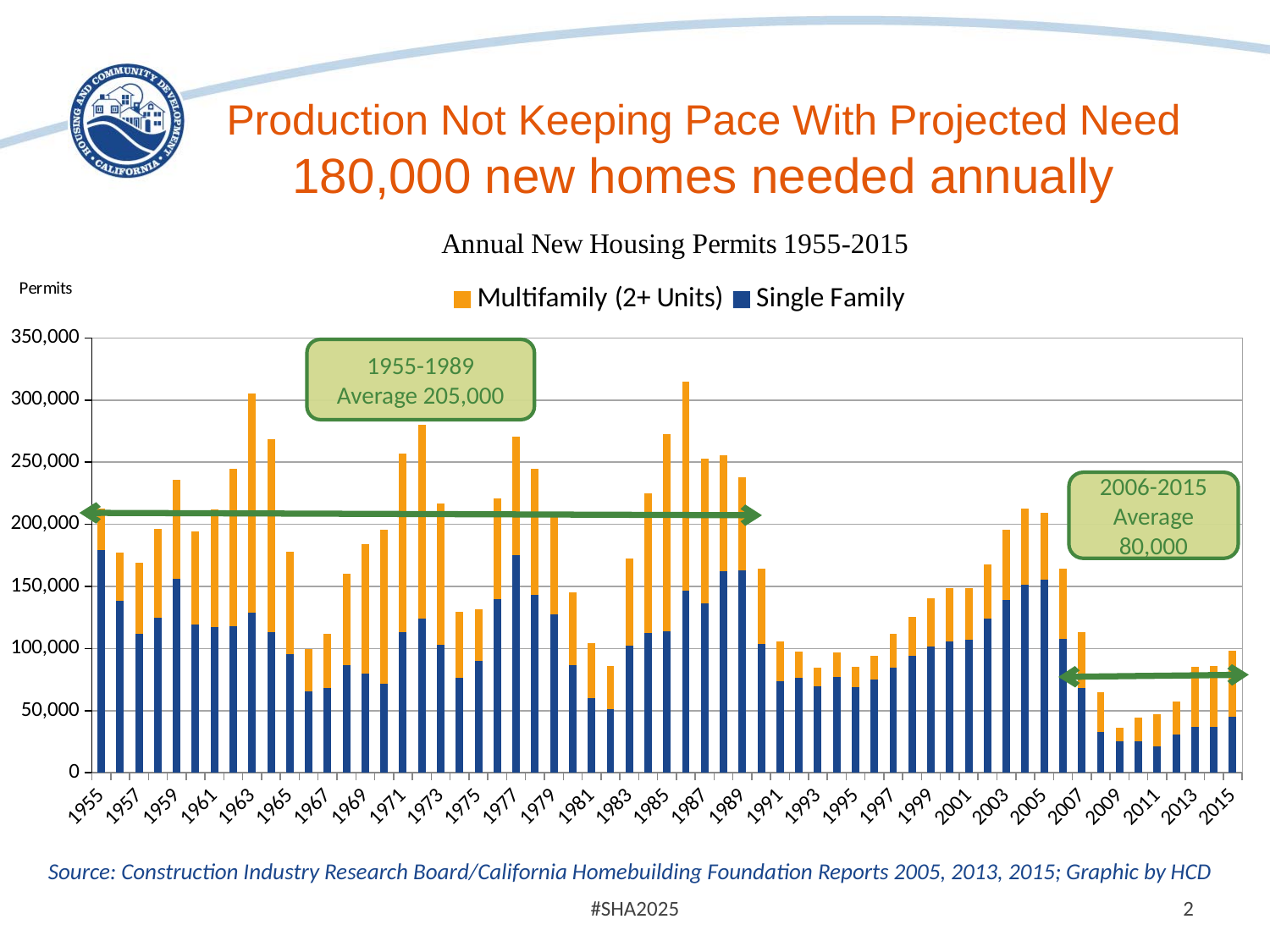
Is the total number of permits for 1986 greater or less than 300,000? greater Is the total number of permits for 1977 greater or less than 250,000? greater How many series does the chart legend list? 2 Which series is shown in orange in the chart? Multifamily (2+ Units) What type of chart is shown on the slide? Stacked bar chart Do total permits rise or fall from 2005 to 2009? fall According to the annotation on the chart, what was the average annual number of permits for 2006-2015? 80,000 According to the annotation on the chart, what was the average annual number of permits for 1955-1989? 205,000 Is the total number of permits for 2009 greater or less than 50,000? less Which year had more total permits, 1977 or 1992? 1977 What is the title of the chart? Annual New Housing Permits 1955-2015 How many years (bars) are plotted in the chart? 61